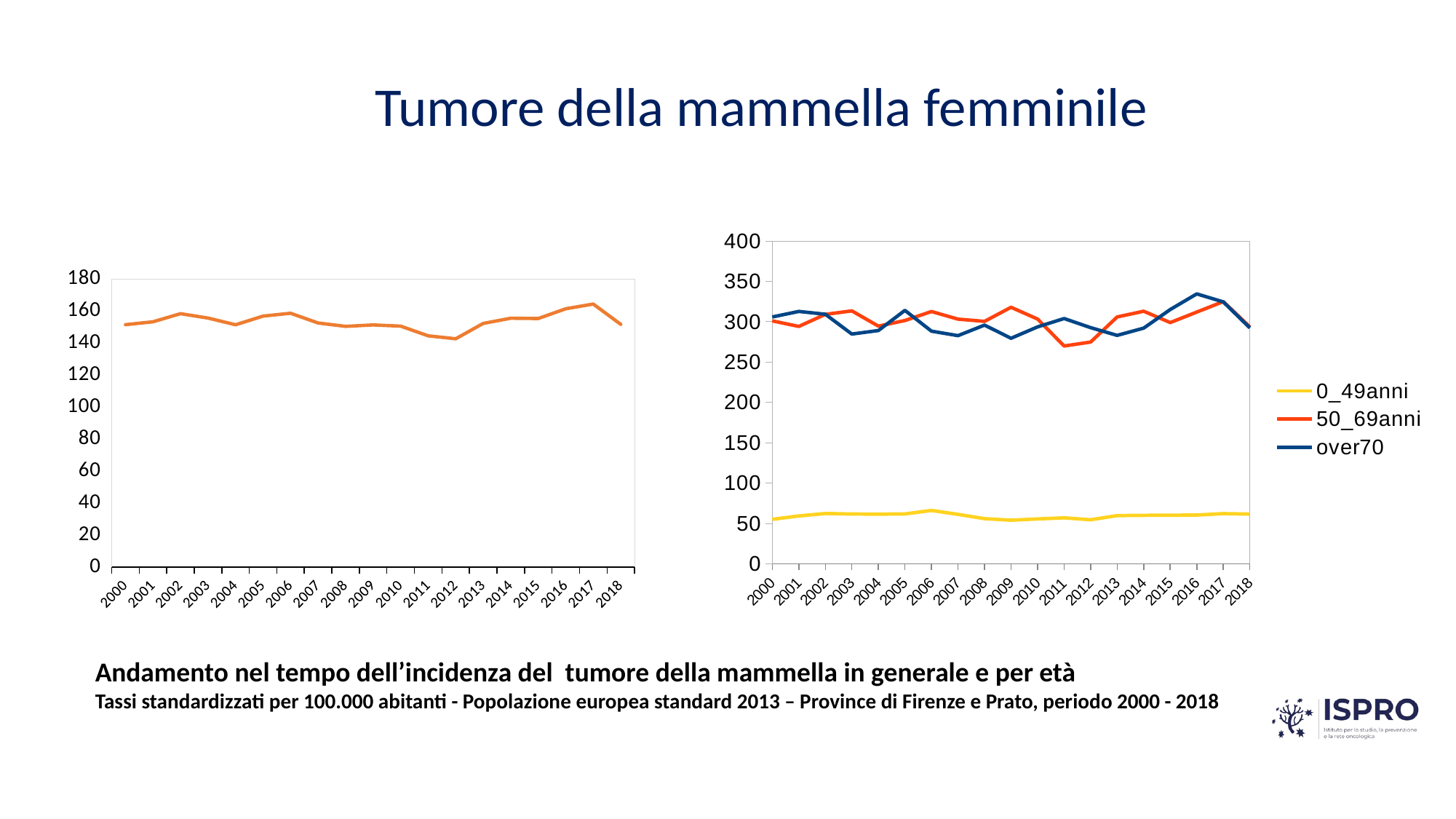
How many series does the legend of the right-hand chart list? 3 In the left-hand chart, is the value for 2012 greater or less than 150? less In the right-hand chart, which series has the lowest values across all years? 0_49anni In the left-hand chart, which year has the highest value? 2017 How many years are shown on the x axis of the left-hand chart? 19 In the right-hand chart, is the value for over70 in 2016 greater or less than 300? greater In the right-hand chart, is the value for 50_69anni in 2011 greater or less than 300? less In the left-hand chart, which year has the lowest value? 2012 In the right-hand chart, which series is larger in 2011: 50_69anni or over70? over70 What kind of chart is the chart on the left of the slide? line chart In the right-hand chart, what colour is the line for the over70 series? blue